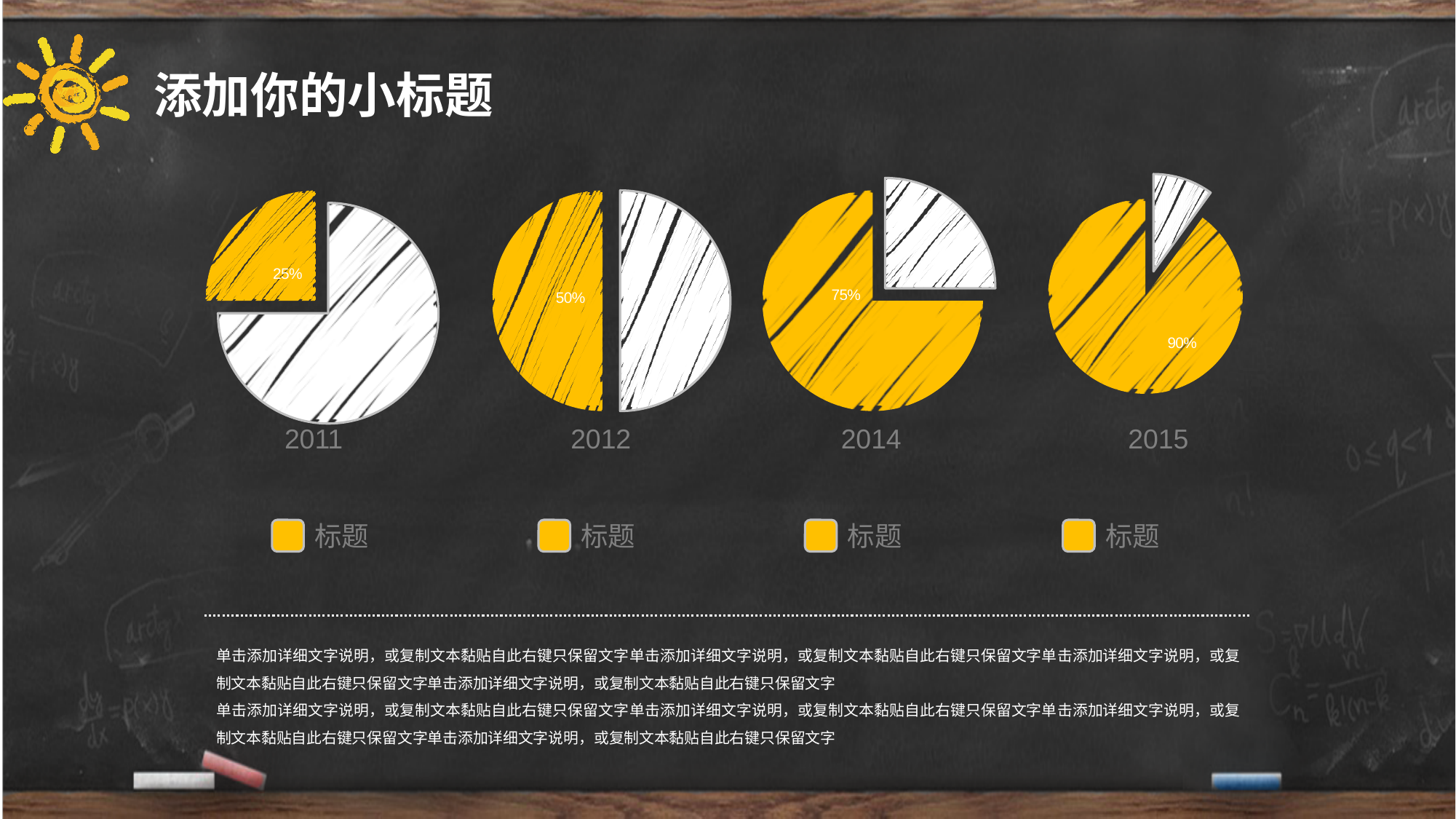
Which pie chart has the smallest yellow slice? 2011 What percentage is shown on the yellow slice of the pie chart labelled 2012? 50% How many slices does each pie chart have? 2 What percentage is shown on the yellow slice of the pie chart labelled 2015? 90% Which pie chart has the largest yellow slice? 2015 Do the yellow slice percentages rise or fall from the 2011 chart to the 2015 chart? Rise How many pie charts are on the slide? 4 What is the difference between the yellow slice percentages of the 2015 and 2011 pie charts? 65% What percentage is shown on the yellow slice of the pie chart labelled 2011? 25% What kind of charts are shown on the slide? Pie charts Is the yellow slice larger in the 2014 pie chart or the 2012 pie chart? 2014 What percentage is shown on the yellow slice of the pie chart labelled 2014? 75%